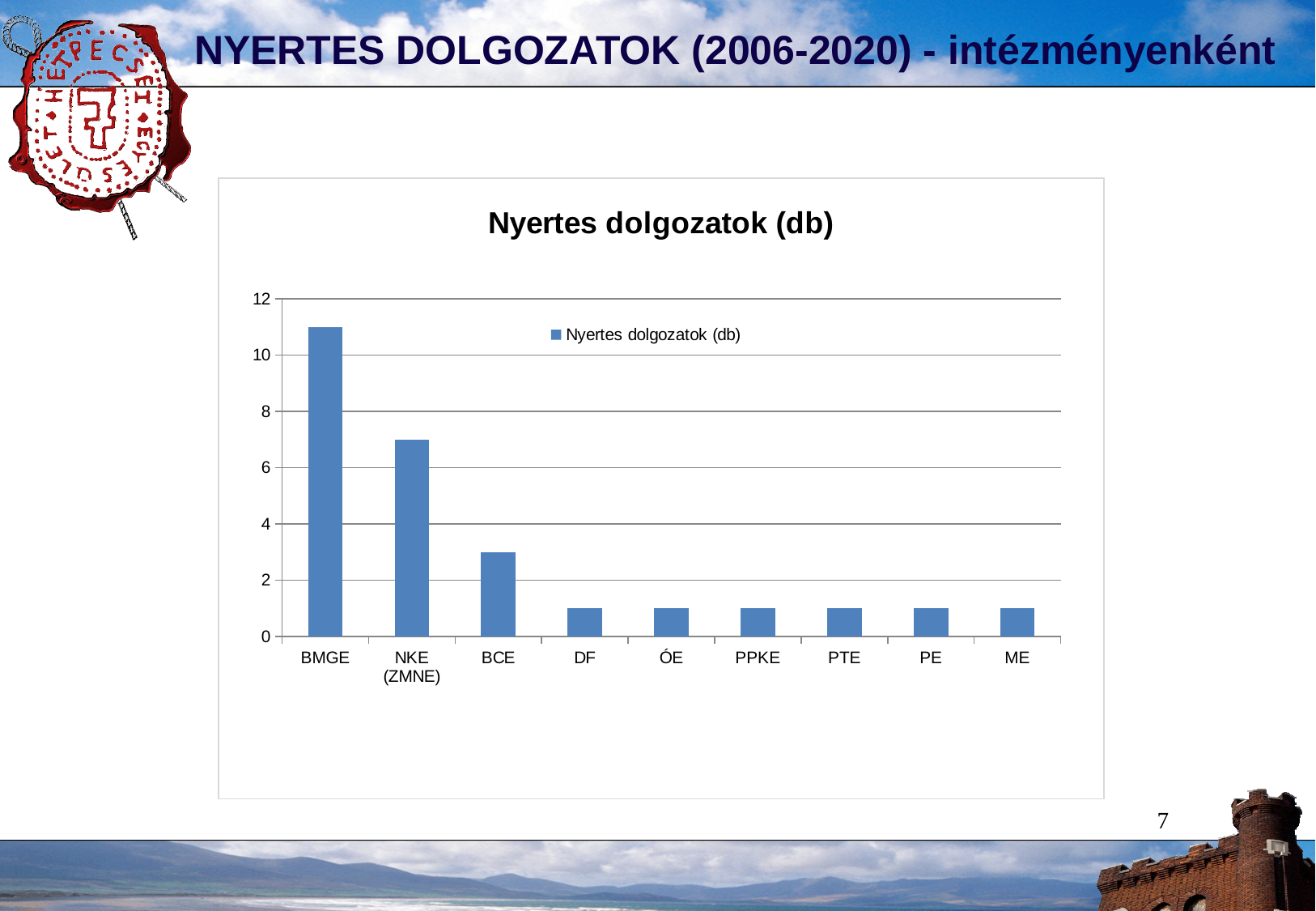
What kind of chart is shown on the slide? bar chart Is the value for NKE (ZMNE) greater or less than 6? greater What is the title of the chart? Nyertes dolgozatok (db) Which has a larger value, BCE or PTE? BCE Is the value for BCE greater or less than 4? less Is the value for BMGE greater or less than 10? greater Do the values generally rise or fall moving from left to right along the x axis? fall How many series does the legend list? 1 Which has a larger value, BMGE or NKE (ZMNE)? BMGE Which institution has the highest number of winning papers (Nyertes dolgozatok)? BMGE How many institutions are shown on the x axis of the chart? 9